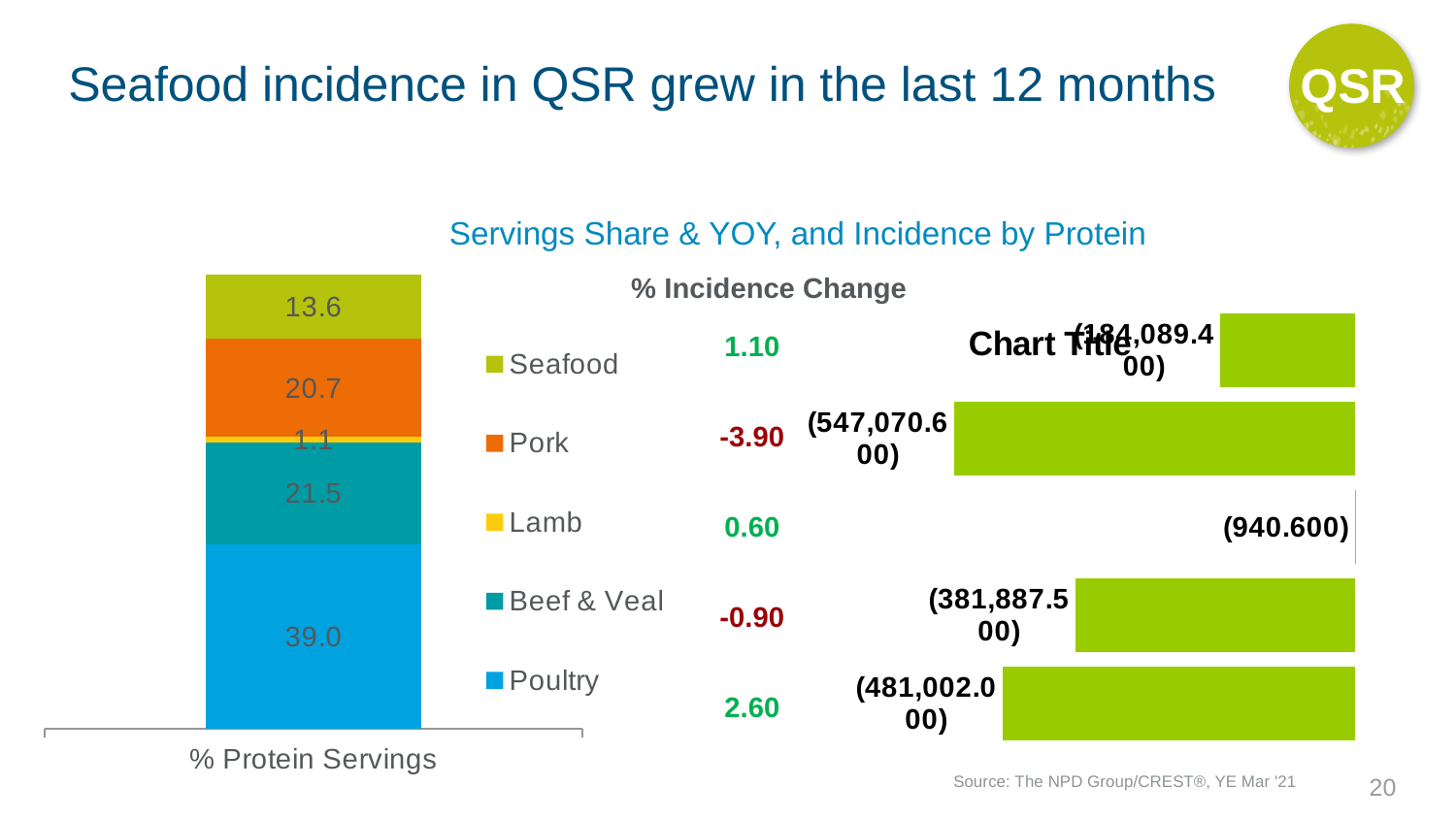
In the % Protein Servings stacked bar chart, which protein has the smallest segment? Lamb In the % Protein Servings stacked bar chart, what is the value of the Seafood segment? 13.6 In the % Protein Servings stacked bar chart, which protein has the largest segment? Poultry In the % Protein Servings stacked bar chart, which segment is larger, Pork or Beef & Veal? Beef & Veal What is the % Incidence Change value shown for Poultry? 2.60 In the % Protein Servings stacked bar chart, what is the value of the Poultry segment? 39.0 In the bar chart on the right titled 'Chart Title', what is the data label on the Lamb bar? (940.600) How many proteins does the legend of the % Protein Servings chart list? 5 What kind of chart is the % Protein Servings chart on the left of the slide? Stacked bar chart What is the % Incidence Change value shown for Pork? -3.90 In the % Protein Servings stacked bar chart, what is the difference between the Beef & Veal segment and the Pork segment? 0.8 In the % Protein Servings stacked bar chart, what is the total of all five segments? 95.9